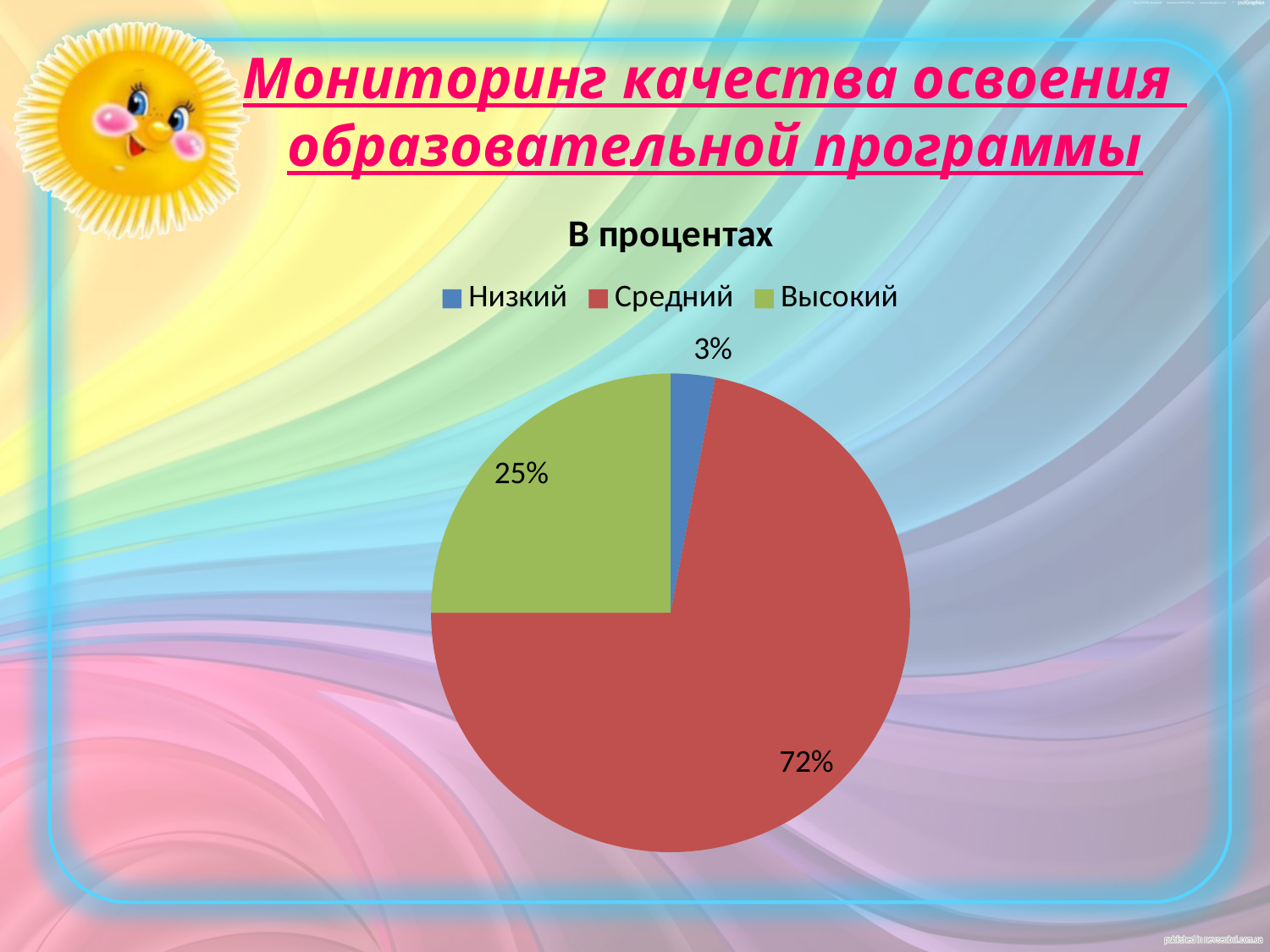
What is the value for Средний? 72% What is the difference between the values for Средний and Высокий? 47% Which is larger, the value for Высокий or the value for Низкий? Высокий What is the value for Высокий? 25% What type of chart is shown on the slide? pie chart What is the chart's title? В процентах Which category has the smallest share of the pie? Низкий What is the difference between the values for Высокий and Низкий? 22% Which category has the largest share of the pie? Средний How many categories does the legend list? 3 What is the value for Низкий? 3% Which colour represents Высокий in the chart? green